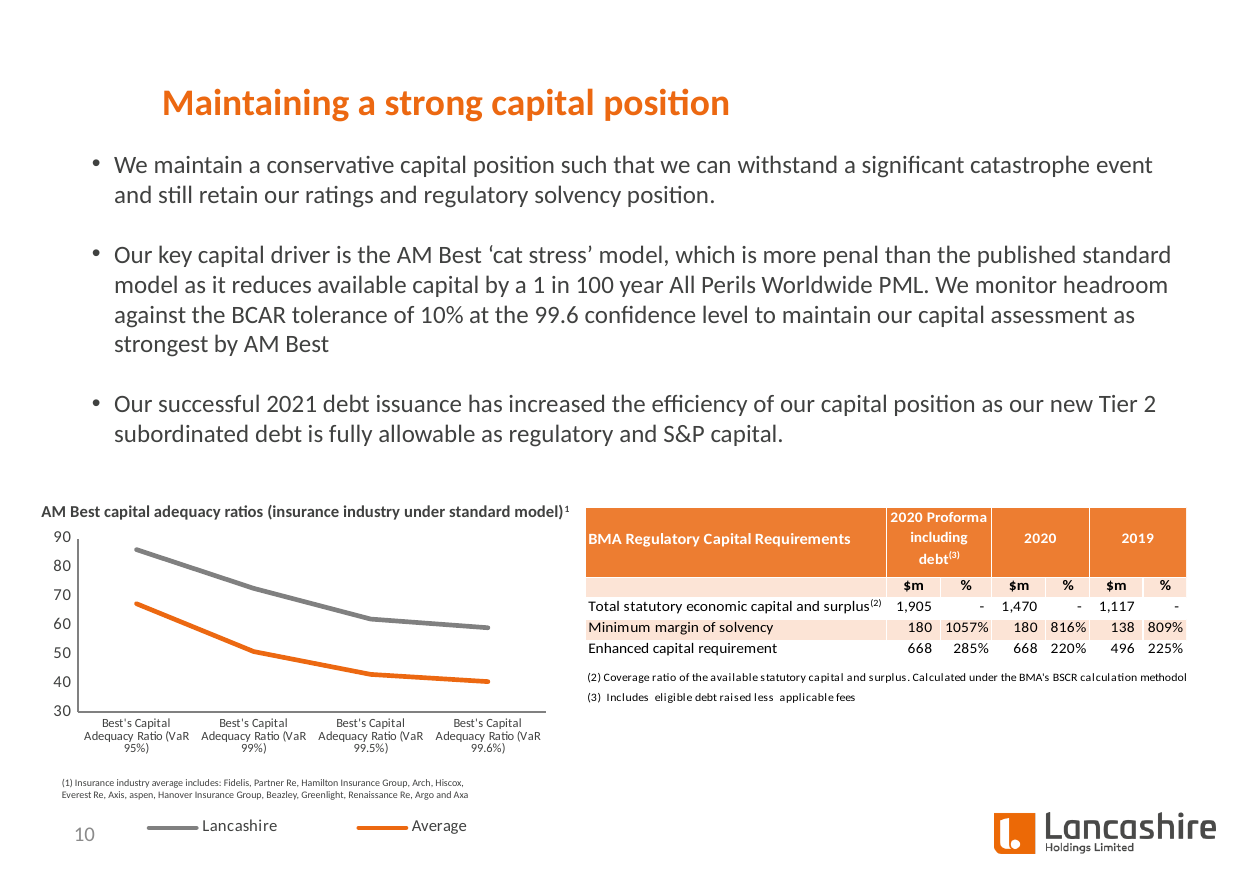
What is the title of the chart? AM Best capital adequacy ratios (insurance industry under standard model) Do the Average values rise or fall along the x axis from left to right? fall Is the Average value for Best's Capital Adequacy Ratio (VaR 99.6%) greater or less than 50? less What kind of chart is shown on the slide? line chart Is the Lancashire value for Best's Capital Adequacy Ratio (VaR 95%) greater or less than 80? greater How many categories are plotted along the x axis of the chart? 4 Do the Lancashire values rise or fall as you move from VaR 95% to VaR 99.6% along the x axis? fall At Best's Capital Adequacy Ratio (VaR 95%), which series has the larger value, Lancashire or Average? Lancashire Is the Average value for Best's Capital Adequacy Ratio (VaR 99%) greater or less than 40? greater At which category does the Lancashire series reach its highest value? Best's Capital Adequacy Ratio (VaR 95%) How many series does the chart legend list? 2